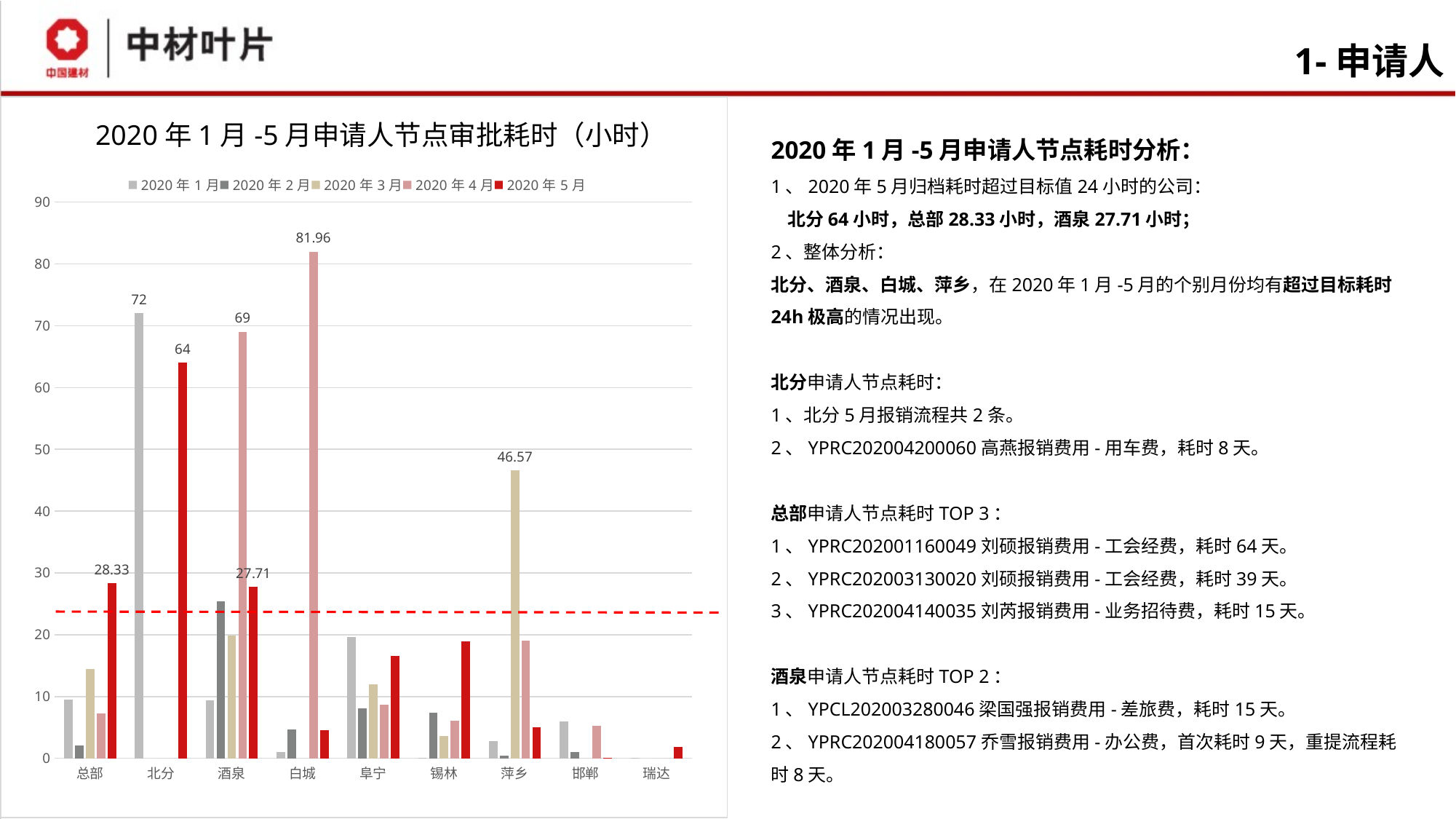
How many categories are shown on the x axis? 9 What is the value for 北分 in the 2020年1月 series? 72 What is the value for 总部 in the 2020年5月 series? 28.33 Is the 2020年1月 value for 阜宁 greater or less than 10? greater How many series does the legend list? 5 What is the difference between the 2020年4月 and 2020年5月 values for 酒泉? 41.29 What is the difference between the 2020年1月 and 2020年5月 values for 北分? 8 What is the value for 萍乡 in the 2020年3月 series? 46.57 What kind of chart is shown on the slide? bar chart What is the value for 白城 in the 2020年4月 series? 81.96 Which category has the highest bar in the chart? 白城 Which is larger: the 2020年5月 value for 总部 or the 2020年5月 value for 酒泉? 总部